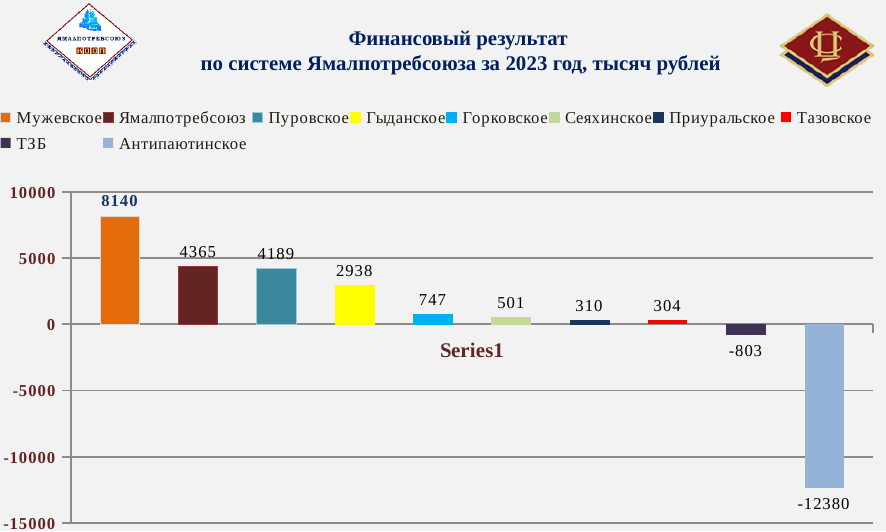
Which category has the highest value? Мужевское What is the title of the chart? Финансовый результат по системе Ямалпотребсоюза за 2023 год, тысяч рублей Which is larger, the value for Горковское or the value for Сеяхинское? Горковское What is the value for Гыданское? 2938 What is the value for Мужевское? 8140 How many bars are plotted in the chart? 10 How many entries does the legend list? 10 Which category has the lowest value? Антипаютинское What is the value for Антипаютинское? -12380 What is the difference between the values for Мужевское and Ямалпотребсоюз? 3775 What is the value for ТЗБ? -803 What kind of chart is shown on the slide? Bar chart